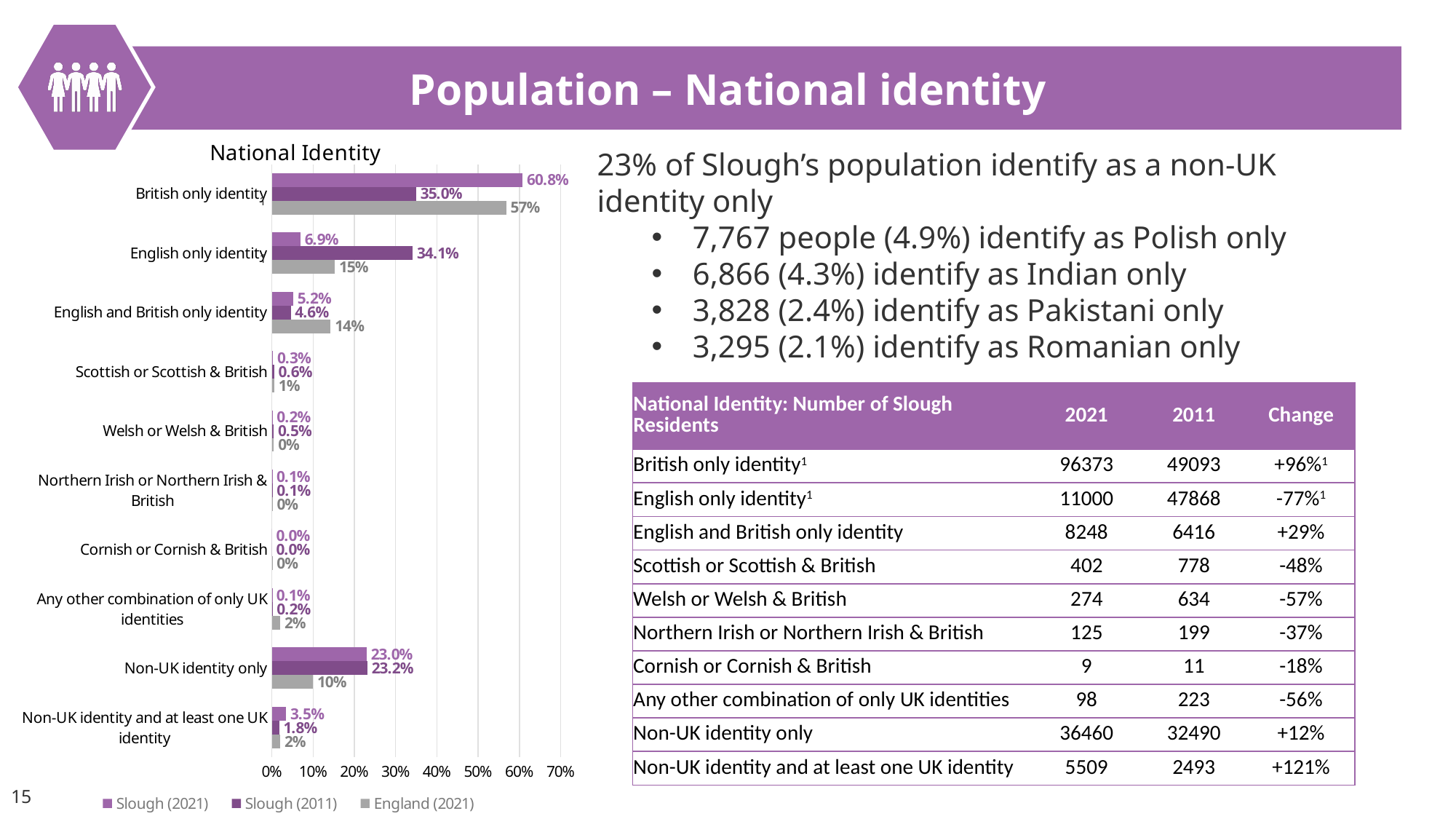
How many categories are shown in the National Identity chart? 10 In the National Identity chart, what is the Slough (2021) value for British only identity? 60.8% In the National Identity chart, what is the Slough (2021) value for Non-UK identity and at least one UK identity? 3.5% In the National Identity chart, which is larger for English only identity: the Slough (2021) value or the England (2021) value? England (2021) In the National Identity chart, what is the difference between the Slough (2021) and Slough (2011) values for British only identity? 25.8% In the National Identity chart, which category has the lowest England (2021) value among those with a non-zero label? Scottish or Scottish & British In the National Identity chart, what is the England (2021) value for Non-UK identity only? 10% How many series does the legend of the National Identity chart list? 3 In the National Identity chart, is the Slough (2021) value for British only identity greater or less than 50%? greater In the National Identity chart, which category has the highest Slough (2021) value? British only identity What kind of chart is the National Identity chart? Bar chart In the National Identity chart, what is the Slough (2011) value for English only identity? 34.1%